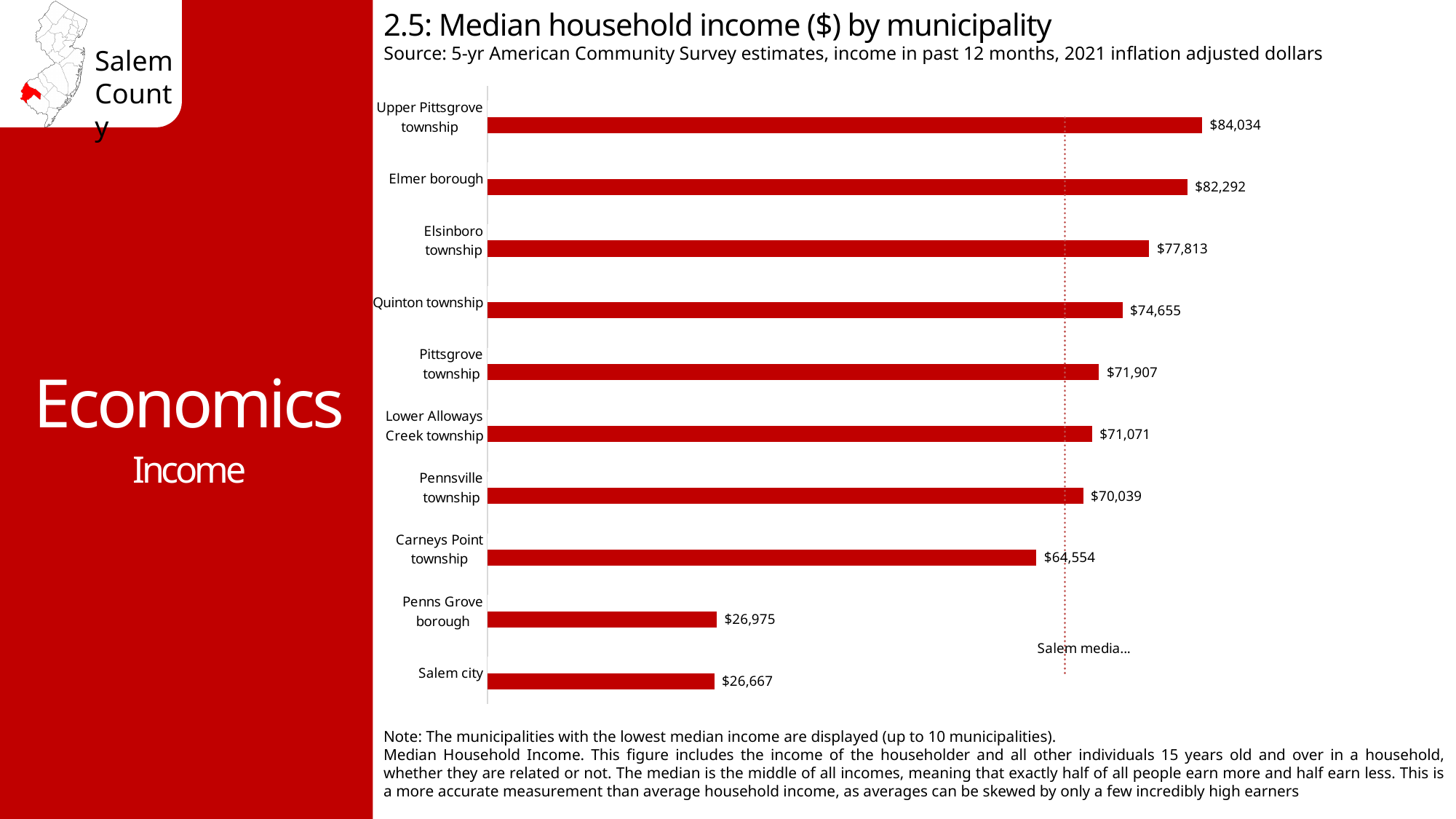
How many municipalities are shown on the chart? 10 What is the median household income for Pennsville township? $70,039 Which municipality has the lowest median household income on the chart? Salem city Which municipality has the highest median household income on the chart? Upper Pittsgrove township What is the median household income for Upper Pittsgrove township? $84,034 What is the median household income for Penns Grove borough? $26,975 What is the difference in median household income between Upper Pittsgrove township and Elmer borough? $1,742 What is the title of the chart? 2.5: Median household income ($) by municipality Which has a higher median household income, Quinton township or Pittsgrove township? Quinton township Which has a higher median household income, Elsinboro township or Lower Alloways Creek township? Elsinboro township What kind of chart is used to show median household income by municipality? Bar chart What is the difference in median household income between Carneys Point township and Penns Grove borough? $37,579